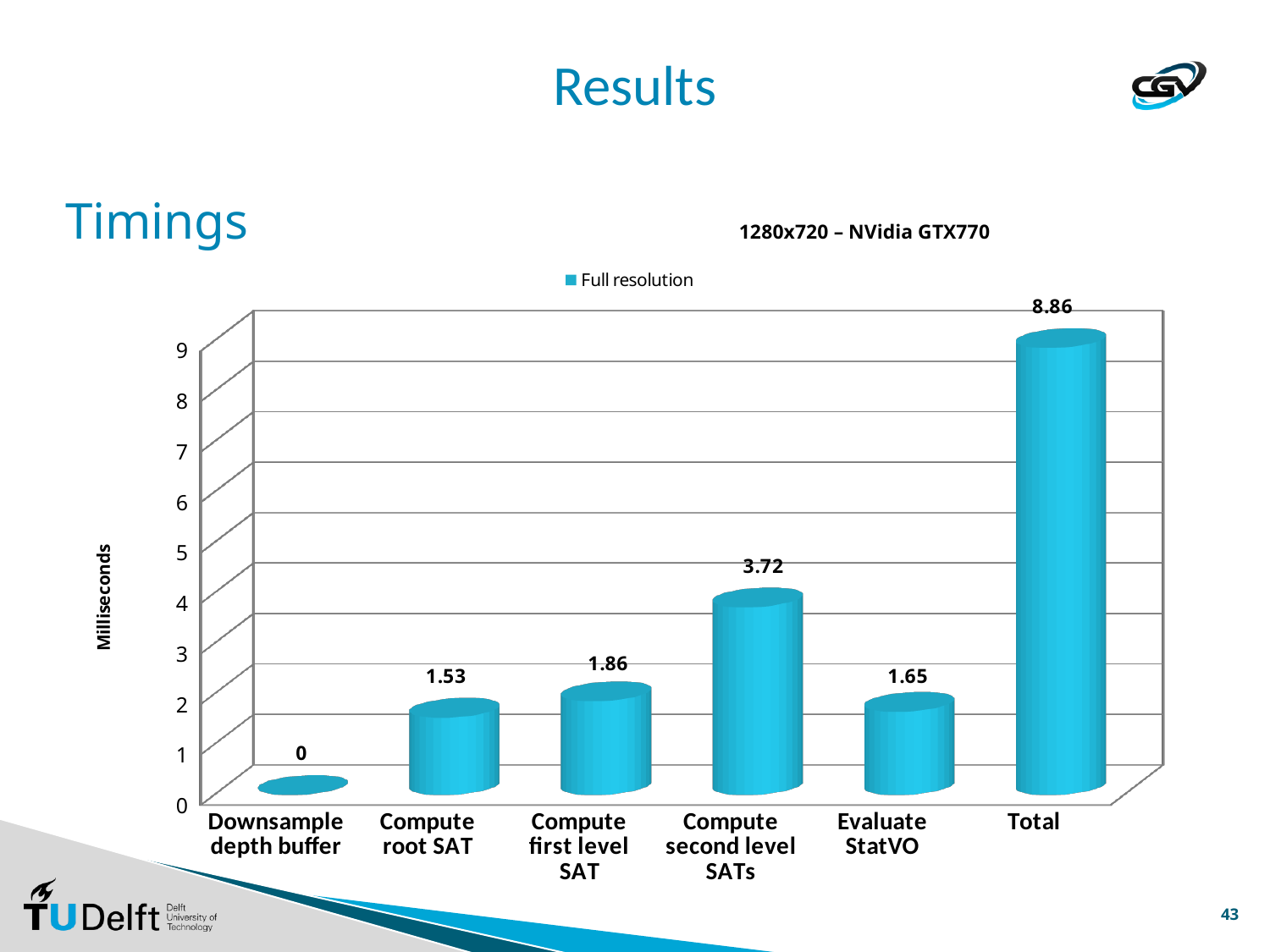
What is the value for Evaluate StatVO? 1.65 What is the difference between Compute second level SATs and Compute first level SAT? 1.86 How many categories are shown on the x axis? 6 Which category has the highest value? Total What is the label of the y axis? Milliseconds Which category has the lowest value? Downsample depth buffer What kind of chart is shown? bar chart What is the value for Compute root SAT? 1.53 How many series does the legend list? 1 What is the value for Total? 8.86 Which is larger, Compute first level SAT or Compute root SAT? Compute first level SAT What is the value for Compute second level SATs? 3.72